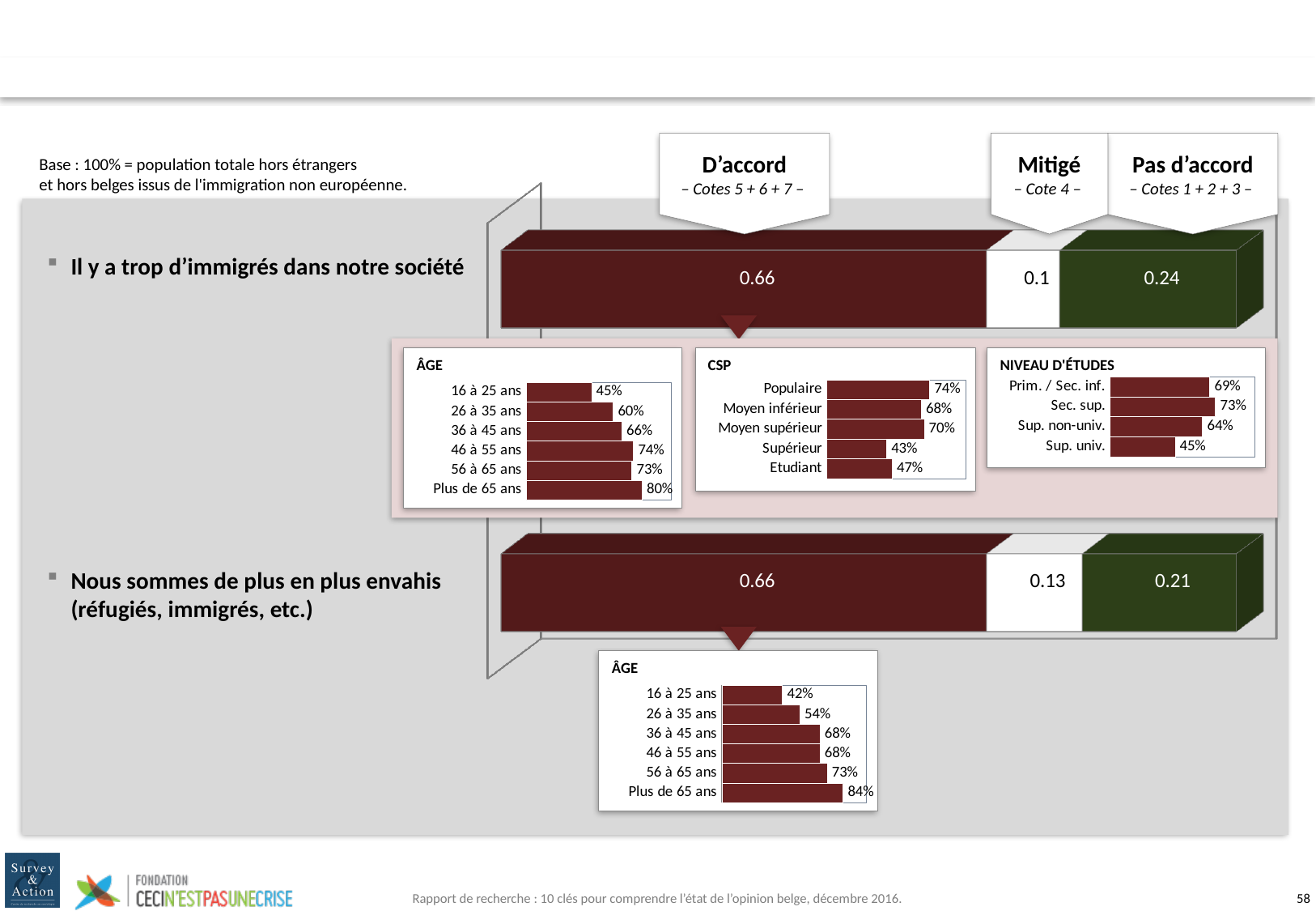
In the stacked bar for "Il y a trop d'immigrés dans notre société", what is the total of the three segments? 1 In the ÂGE chart under "Nous sommes de plus en plus envahis", what is the value for "Plus de 65 ans"? 84% In the NIVEAU D'ÉTUDES chart, how many categories are shown? 4 In the ÂGE chart under "Il y a trop d'immigrés dans notre société", which age group has the highest value? Plus de 65 ans In the NIVEAU D'ÉTUDES chart, what is the value for "Sec. sup."? 73% In the stacked bar for "Nous sommes de plus en plus envahis (réfugiés, immigrés, etc.)", what is the value for "Mitigé"? 0.13 In the ÂGE chart under "Il y a trop d'immigrés dans notre société", what is the value for "26 à 35 ans"? 60% In the ÂGE chart under "Nous sommes de plus en plus envahis", which is larger, "16 à 25 ans" or "26 à 35 ans"? 26 à 35 ans In the CSP chart, which category has the lowest value? Supérieur What kind of chart is the CSP chart? Bar chart In the stacked bar for "Il y a trop d'immigrés dans notre société", what is the value for "D'accord"? 0.66 In the CSP chart, what is the difference between "Populaire" and "Etudiant"? 27%